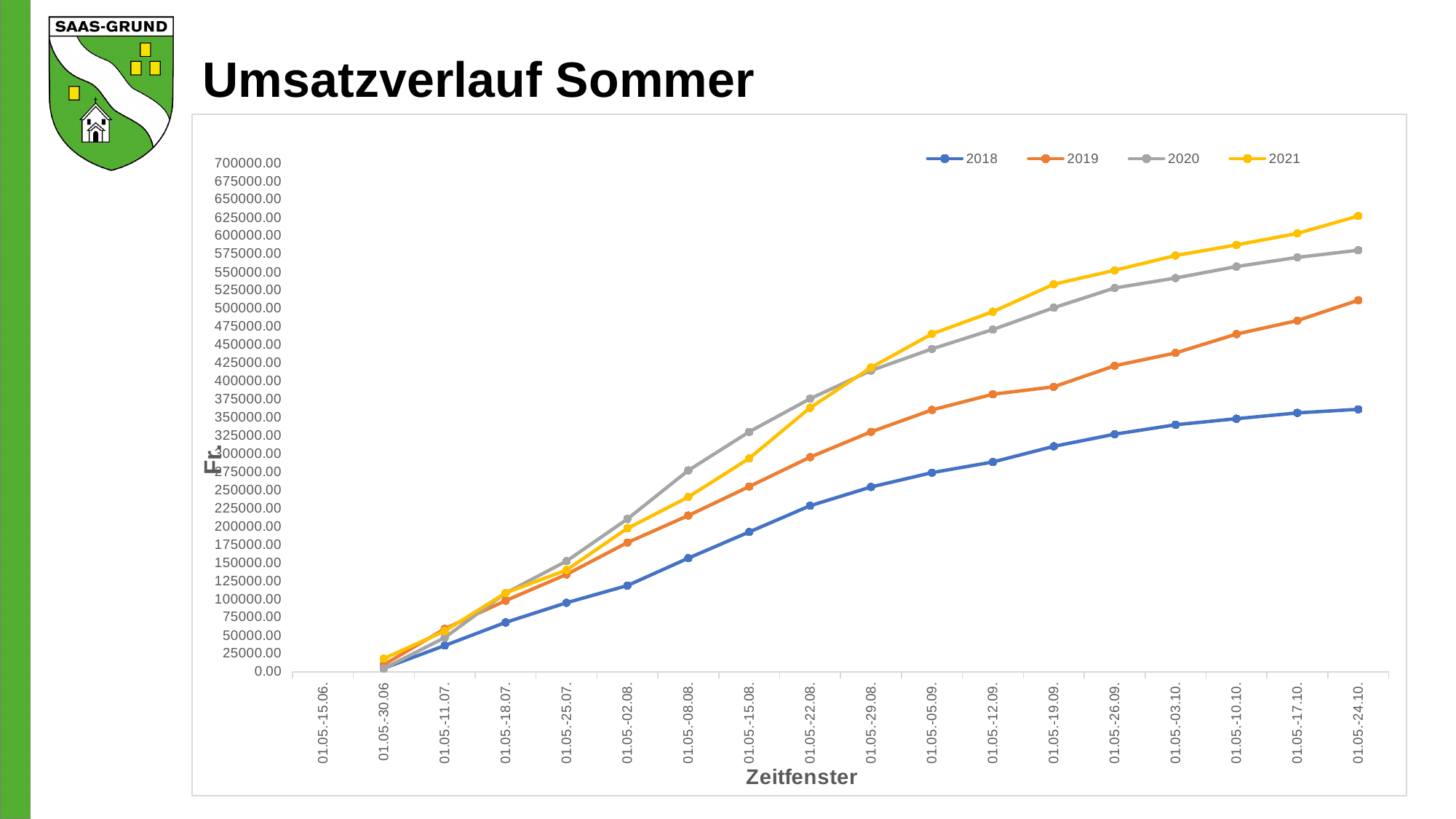
At 01.05.-15.08., which series has the larger value, 2020 or 2021? 2020 How many series does the legend list? 4 Which series has the lowest value at 01.05.-24.10.? 2018 Is the value for 2020 at 01.05.-24.10. greater or less than 550000.00? greater What is the label of the x axis? Zeitfenster Do the values for 2018 rise or fall along the x axis? rise Which series has the highest value at 01.05.-24.10.? 2021 Is the value for 2018 at 01.05.-22.08. greater or less than 250000.00? less How many categories are shown on the x axis (Zeitfenster)? 18 What kind of chart is shown on the slide? line chart Is the value for 2019 at 01.05.-12.09. greater or less than 400000.00? less